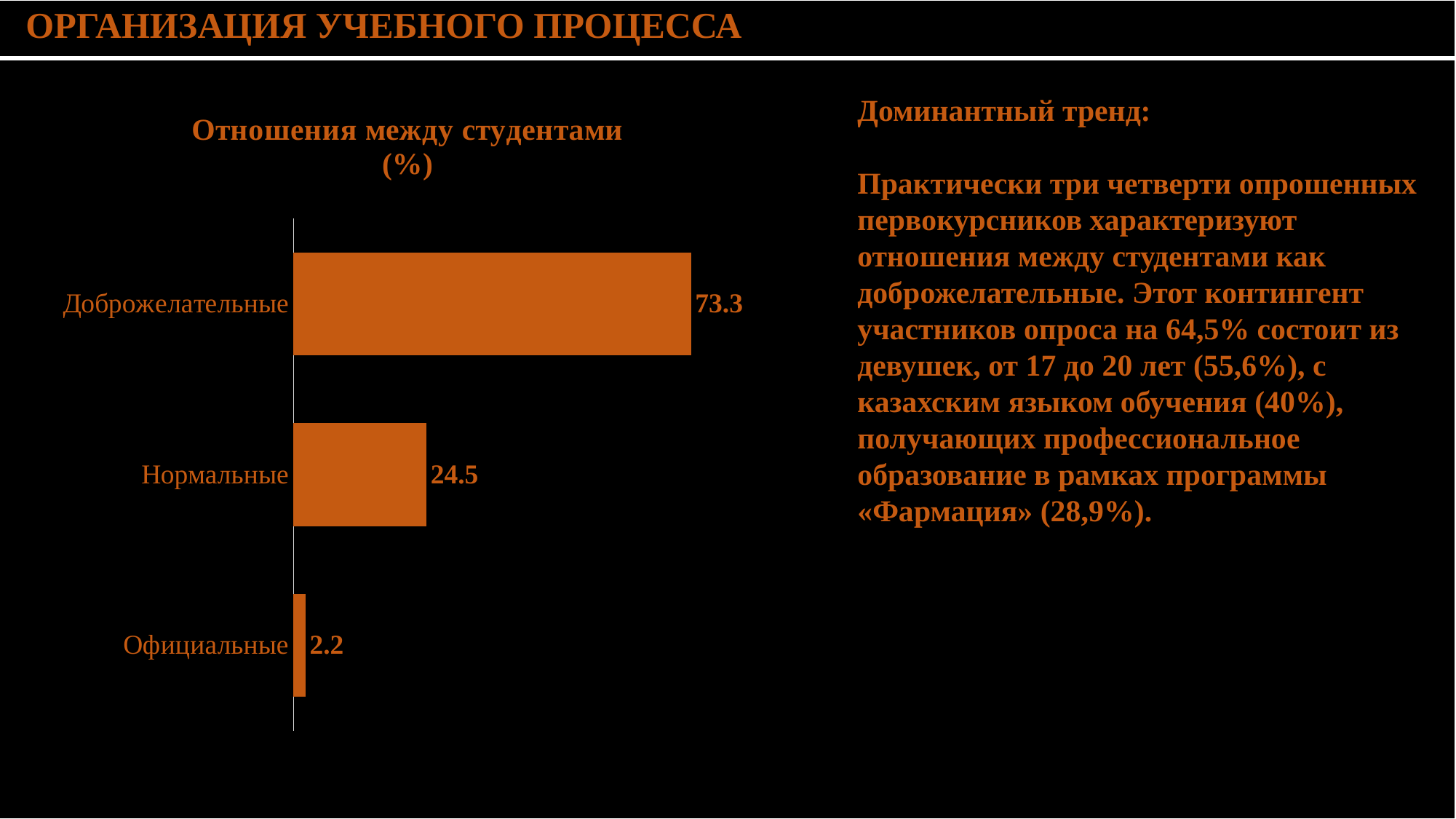
What is the value for Официальные? 2.2 What is the difference between the values for Нормальные and Официальные? 22.3 What is the difference between the values for Доброжелательные and Нормальные? 48.8 What is the value for Нормальные? 24.5 What kind of chart is shown on the slide? bar chart Which category has the lowest value? Официальные Which category has the highest value? Доброжелательные What colour are the bars in the chart? orange What is the value for Доброжелательные? 73.3 What is the title of the chart? Отношения между студентами (%) Which is larger, the value for Нормальные or the value for Официальные? Нормальные How many categories are shown in the chart? 3